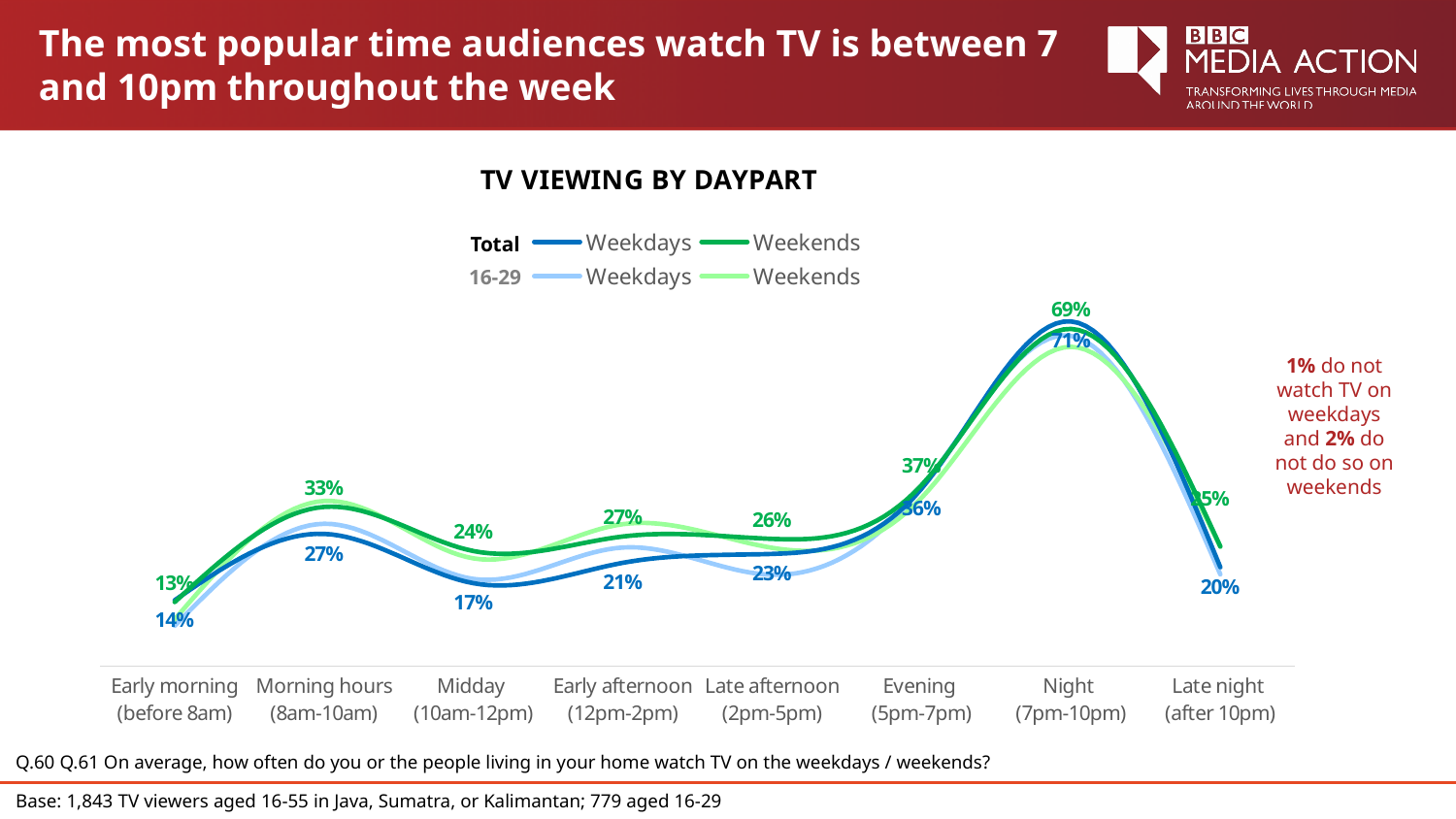
Which daypart has the highest TV viewing values? Night (7pm-10pm) At Midday (10am-12pm), is the labelled weekend value or the labelled weekday value larger? Weekend (24%) What is the title of the chart? TV VIEWING BY DAYPART Which daypart has the lowest labelled weekday value? Early morning (before 8am) What weekend value is labelled at Night (7pm-10pm)? 69% How many series does the chart legend list? 4 What is the difference between the labelled weekend value (33%) and weekday value (27%) at Morning hours? 6 percentage points What weekday value is labelled at Midday (10am-12pm)? 17% What type of chart is shown on the slide? Line chart What weekday value is labelled at Night (7pm-10pm)? 71% How many dayparts are shown along the x axis of the chart? 8 What weekend value is labelled at Morning hours (8am-10am)? 33%